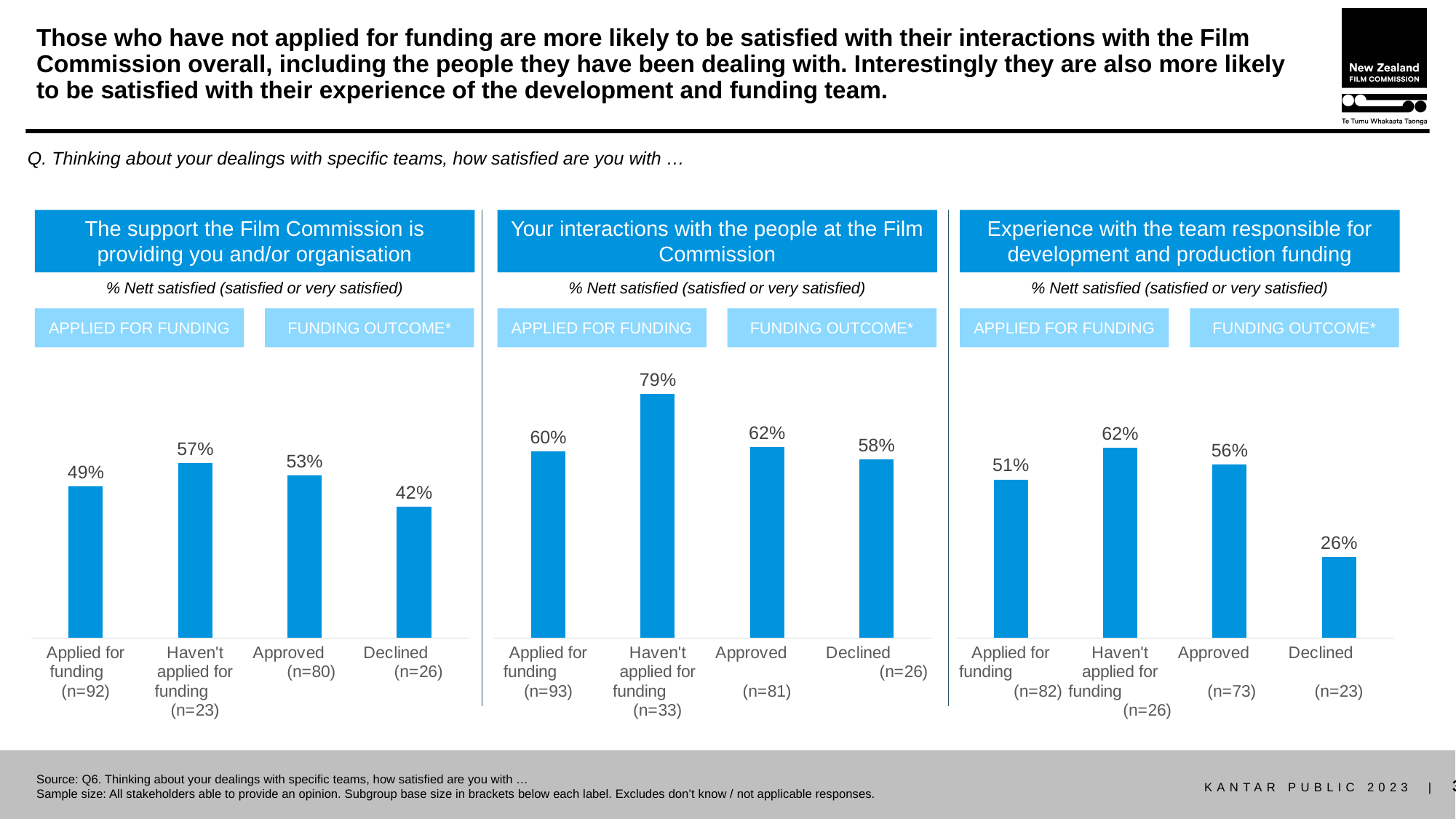
What kind of chart is used in the chart titled 'Your interactions with the people at the Film Commission'? Bar chart In the chart titled 'Your interactions with the people at the Film Commission', which is larger: 'Applied for funding' or 'Approved'? Approved In the chart titled 'The support the Film Commission is providing you and/or organisation', what is the difference between 'Haven't applied for funding' and 'Declined'? 15% In the chart titled 'Experience with the team responsible for development and production funding', what is the difference between 'Approved' and 'Declined'? 30% How many categories are shown in the chart titled 'The support the Film Commission is providing you and/or organisation'? 4 In the chart titled 'Experience with the team responsible for development and production funding', what is the % nett satisfied for 'Applied for funding'? 51% In the chart titled 'Experience with the team responsible for development and production funding', which category has the lowest % nett satisfied? Declined In the chart titled 'Your interactions with the people at the Film Commission', which category has the highest % nett satisfied? Haven't applied for funding In the chart titled 'The support the Film Commission is providing you and/or organisation', what is the sample size shown for 'Approved'? n=80 In the chart titled 'Experience with the team responsible for development and production funding', what is the % nett satisfied for 'Approved'? 56% In the chart titled 'Your interactions with the people at the Film Commission', what is the % nett satisfied for 'Declined'? 58% In the chart titled 'The support the Film Commission is providing you and/or organisation', what is the % nett satisfied for 'Haven't applied for funding'? 57%